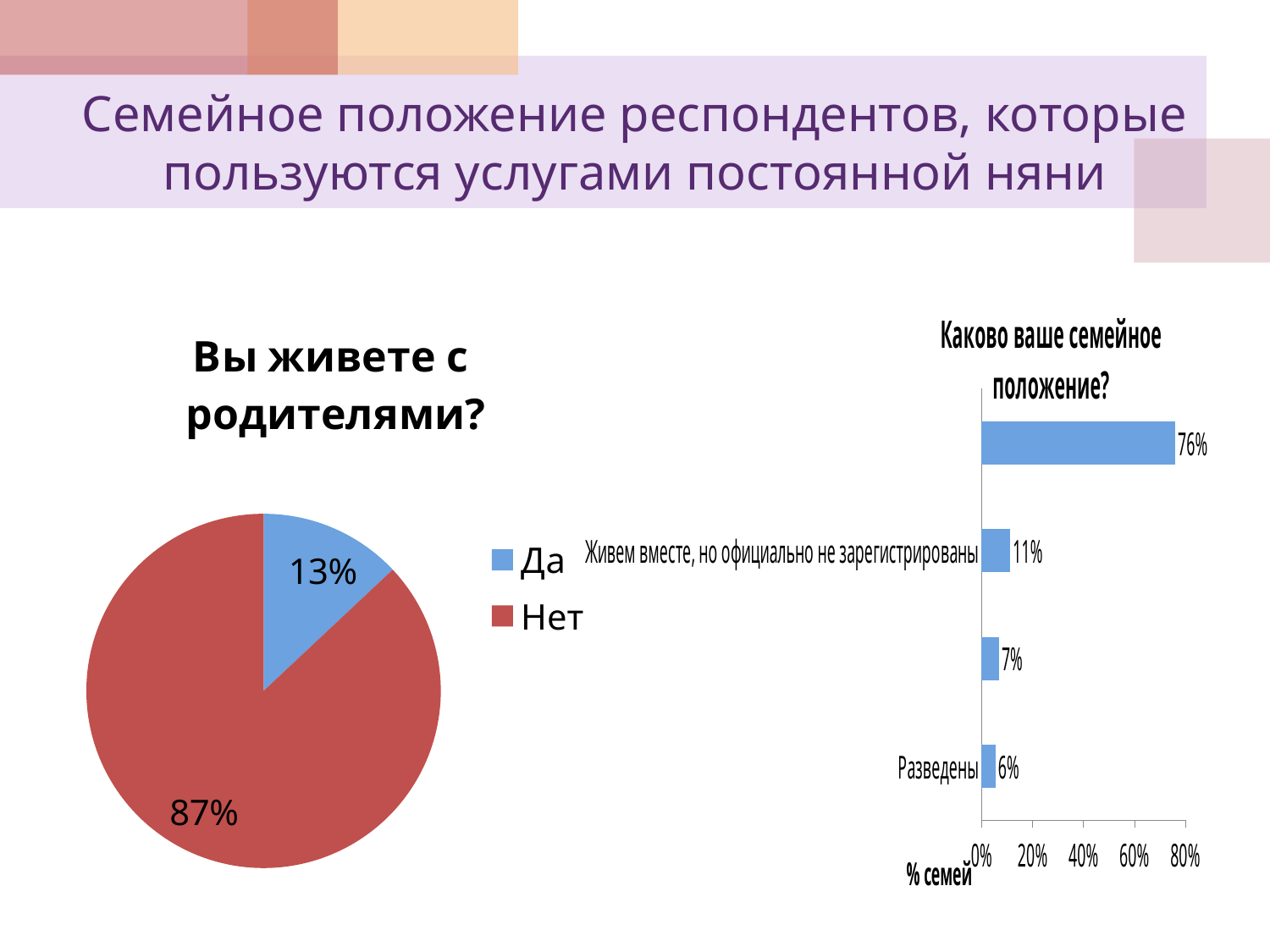
In the pie chart 'Вы живете с родителями?', what percentage of respondents answered 'Да'? 13% In the pie chart 'Вы живете с родителями?', what is the difference in percentage points between 'Нет' and 'Да'? 74 In the chart 'Каково ваше семейное положение?', what is the value for 'Живем вместе, но официально не зарегистрированы'? 11% In the pie chart 'Вы живете с родителями?', which answer has the larger share? Нет In the chart 'Каково ваше семейное положение?', what is the value for 'Разведены'? 6% What type of chart is 'Каково ваше семейное положение?'? Bar chart In the chart 'Каково ваше семейное положение?', how many bars are plotted? 4 What type of chart is the chart on the left of the slide? Pie chart In the chart 'Каково ваше семейное положение?', which is larger: the value for 'Живем вместе, но официально не зарегистрированы' or the value for 'Разведены'? Живем вместе, но официально не зарегистрированы How many entries does the legend of the pie chart 'Вы живете с родителями?' list? 2 In the chart 'Каково ваше семейное положение?', what is the largest value shown on any bar? 76% In the pie chart 'Вы живете с родителями?', what percentage of respondents answered 'Нет'? 87%